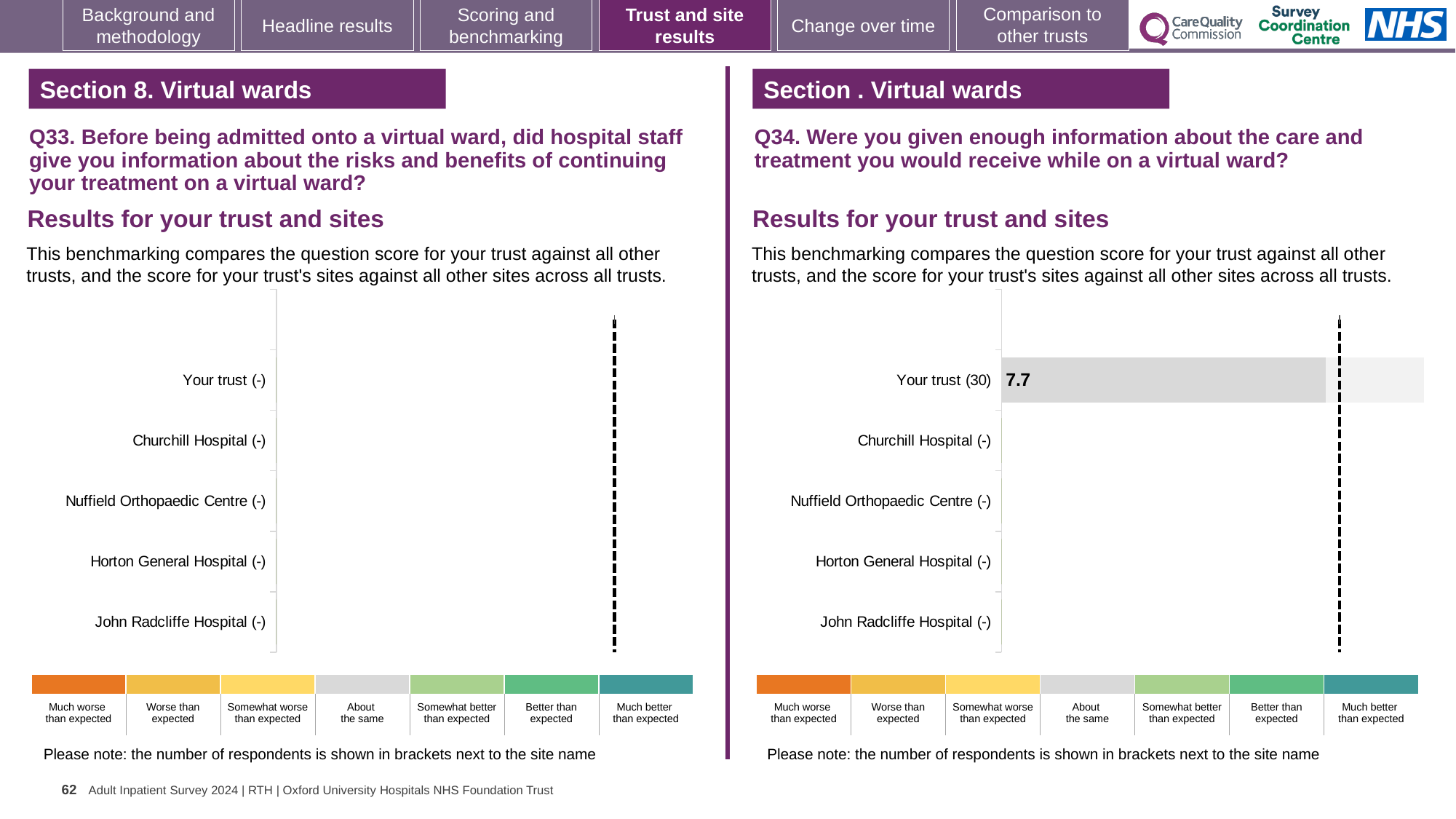
On the Q34 chart (right), what is the score shown for Your trust? 7.7 On the Q34 chart (right), how many benchmark bands are shown in the colour key below the chart? 7 On the Q34 chart (right), how many respondents are shown in brackets next to Your trust? 30 On the Q34 chart (right), which category is the only one with a plotted bar? Your trust (30) On the Q33 chart (left), how many sites have a plotted score? 0 On the Q34 chart (right), is the score for Your trust greater or less than 5? greater What kind of chart is the Q34 chart on the right? Bar chart On the Q33 chart (left), how many categories are listed on the vertical axis? 5 On the Q34 chart (right), how many categories are listed on the vertical axis? 5 On the Q34 chart (right), which category appears at the bottom of the vertical axis? John Radcliffe Hospital (-)